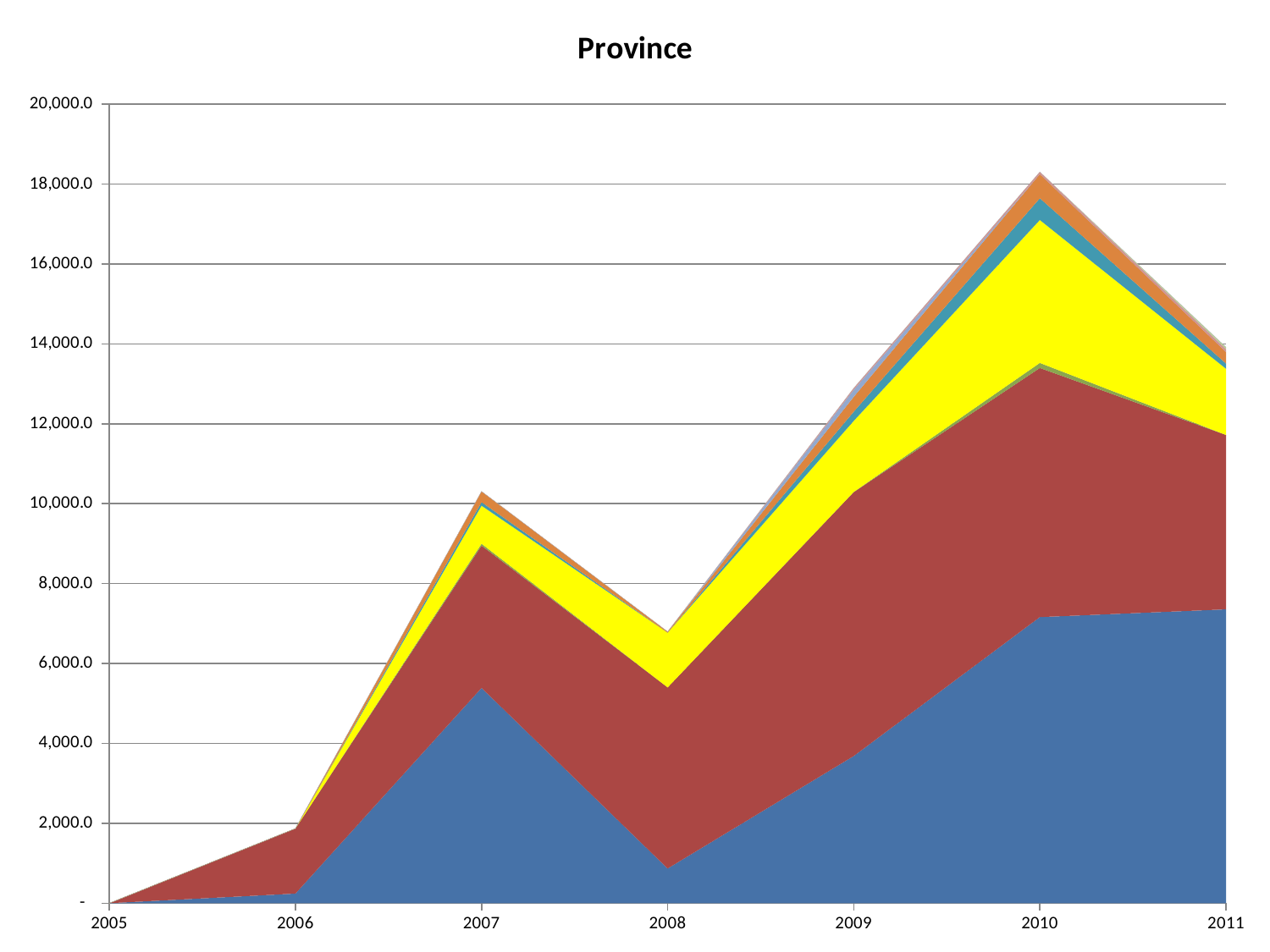
What is the title of the chart? Province In which year is the stacked total at its lowest? 2005 Is the stacked total for 2010 greater or less than 16,000? greater In which year does the stacked total reach its highest value? 2010 Is the value of the bottom blue series in 2011 greater or less than 6,000? greater Which year has the larger stacked total, 2009 or 2011? 2011 Is the value of the bottom blue series in 2007 greater or less than 4,000? greater How many years are shown along the x axis of the chart? 7 What kind of chart is shown on the slide? stacked area chart Does the stacked total rise or fall from 2008 to 2010? rise